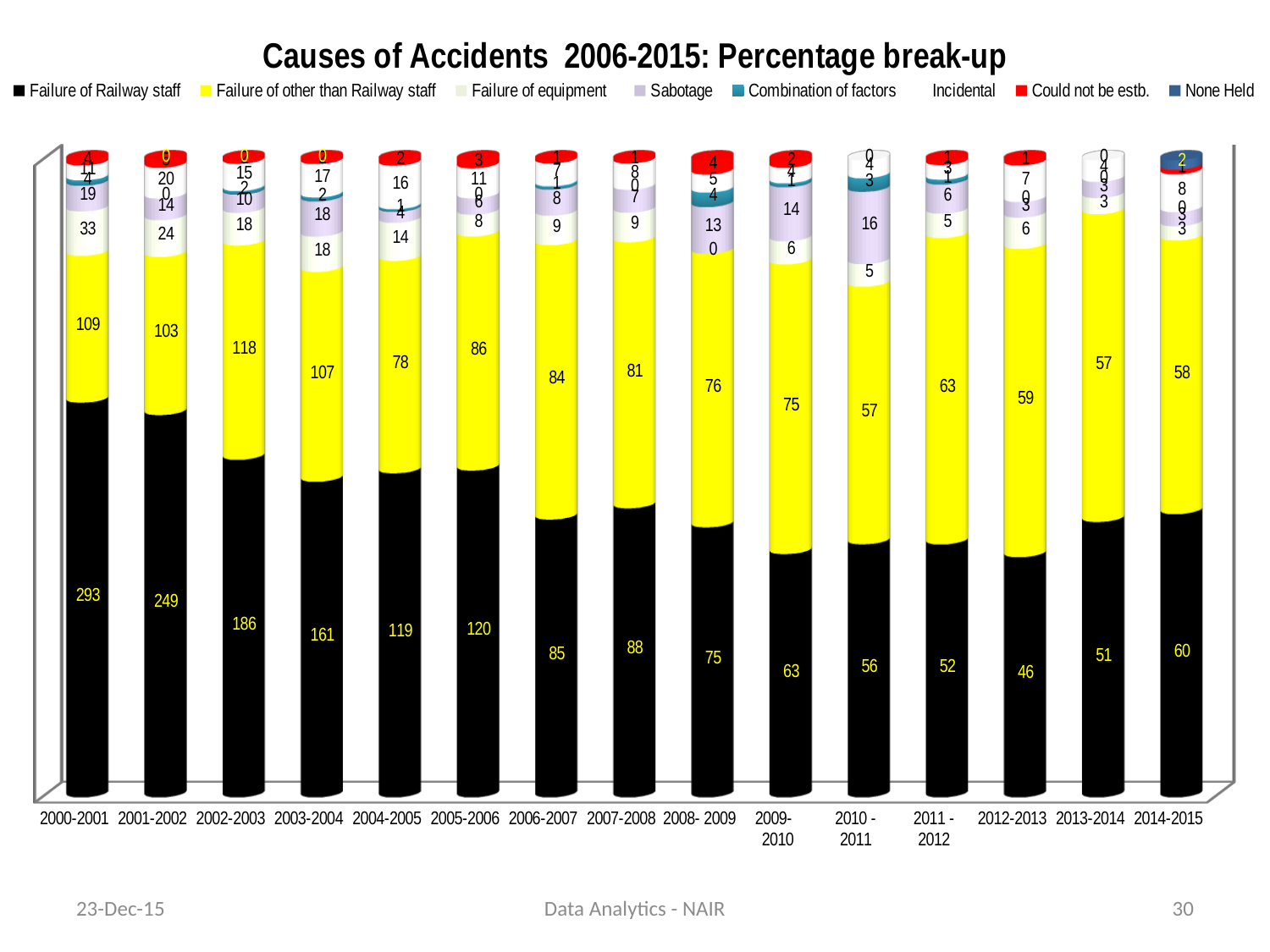
In which year is the value for Failure of Railway staff lowest? 2012-2013 What is the difference between the Failure of Railway staff values for 2000-2001 and 2001-2002? 44 What kind of chart is shown on the slide? Stacked bar chart In 2000-2001, which is larger: Failure of Railway staff or Failure of other than Railway staff? Failure of Railway staff What is the value for Failure of Railway staff in 2000-2001? 293 How many series does the legend list? 8 In which year is the value for Failure of Railway staff highest? 2000-2001 What is the value for Failure of Railway staff in 2014-2015? 60 What is the value for Failure of equipment in 2000-2001? 33 Do the values for Failure of Railway staff generally rise or fall from 2000-2001 to 2014-2015? Fall How many year categories are shown along the x axis? 15 What is the value for Failure of other than Railway staff in 2002-2003? 118